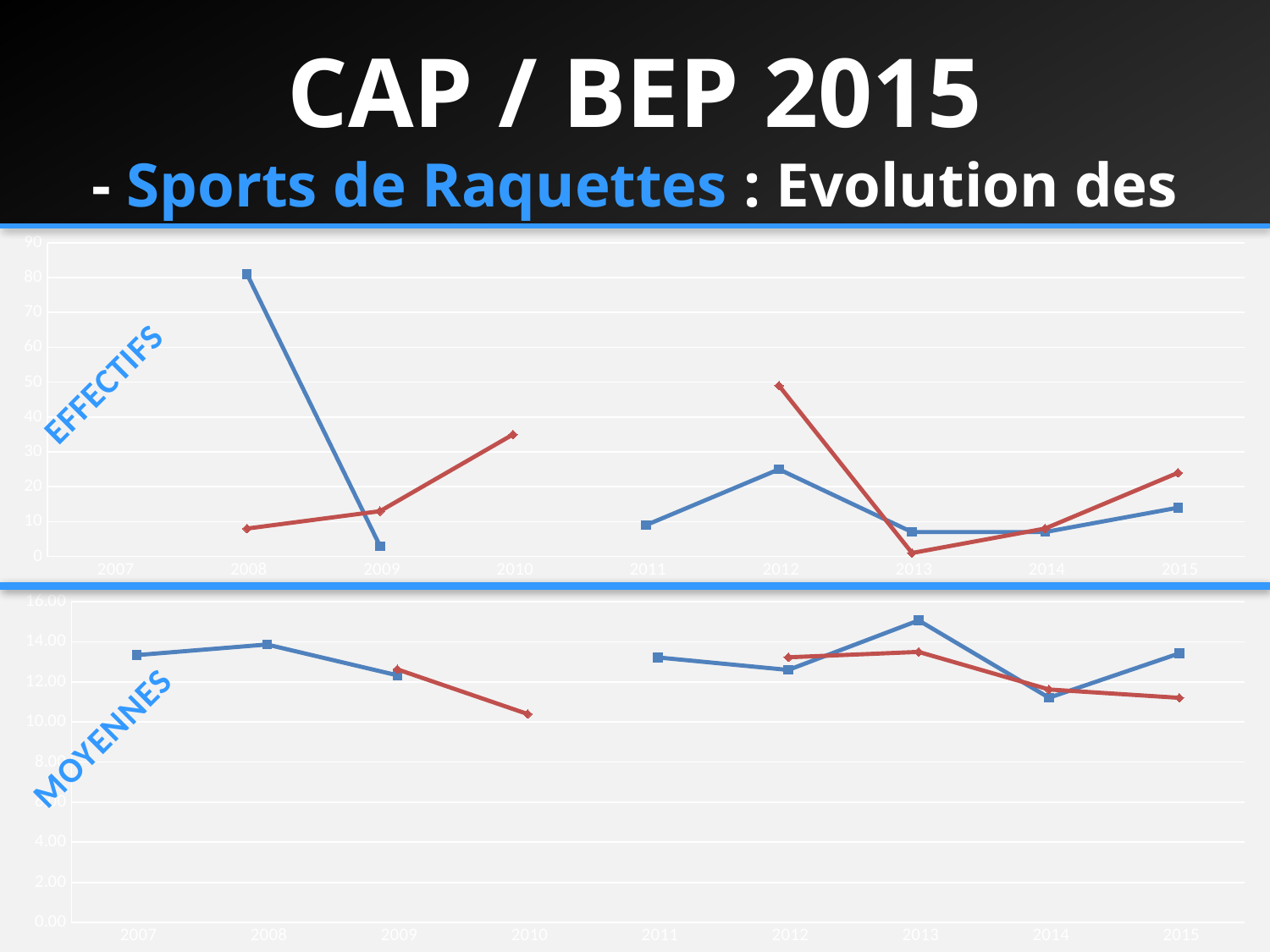
In the bottom chart (MOYENNES), which year has the highest value on the blue line? 2013 In the top chart (EFFECTIFS), which year has the highest value on the blue line? 2008 How many years are shown on the x axis of the top chart (EFFECTIFS)? 9 In the bottom chart (MOYENNES), is the red line's value for 2010 greater or less than 12.00? less In the bottom chart (MOYENNES), does the red line rise or fall from 2013 to 2015? fall In the top chart (EFFECTIFS), is the red line's value for 2012 greater or less than 40? greater In the top chart (EFFECTIFS), is the blue line's value for 2008 greater or less than 70? greater In the top chart (EFFECTIFS), for 2009, which line has the larger value, the blue or the red? red In the top chart (EFFECTIFS), does the blue line rise or fall from 2008 to 2009? fall What kind of chart is the top chart labelled EFFECTIFS? line chart In the top chart (EFFECTIFS), for 2012, which line has the larger value, the blue or the red? red